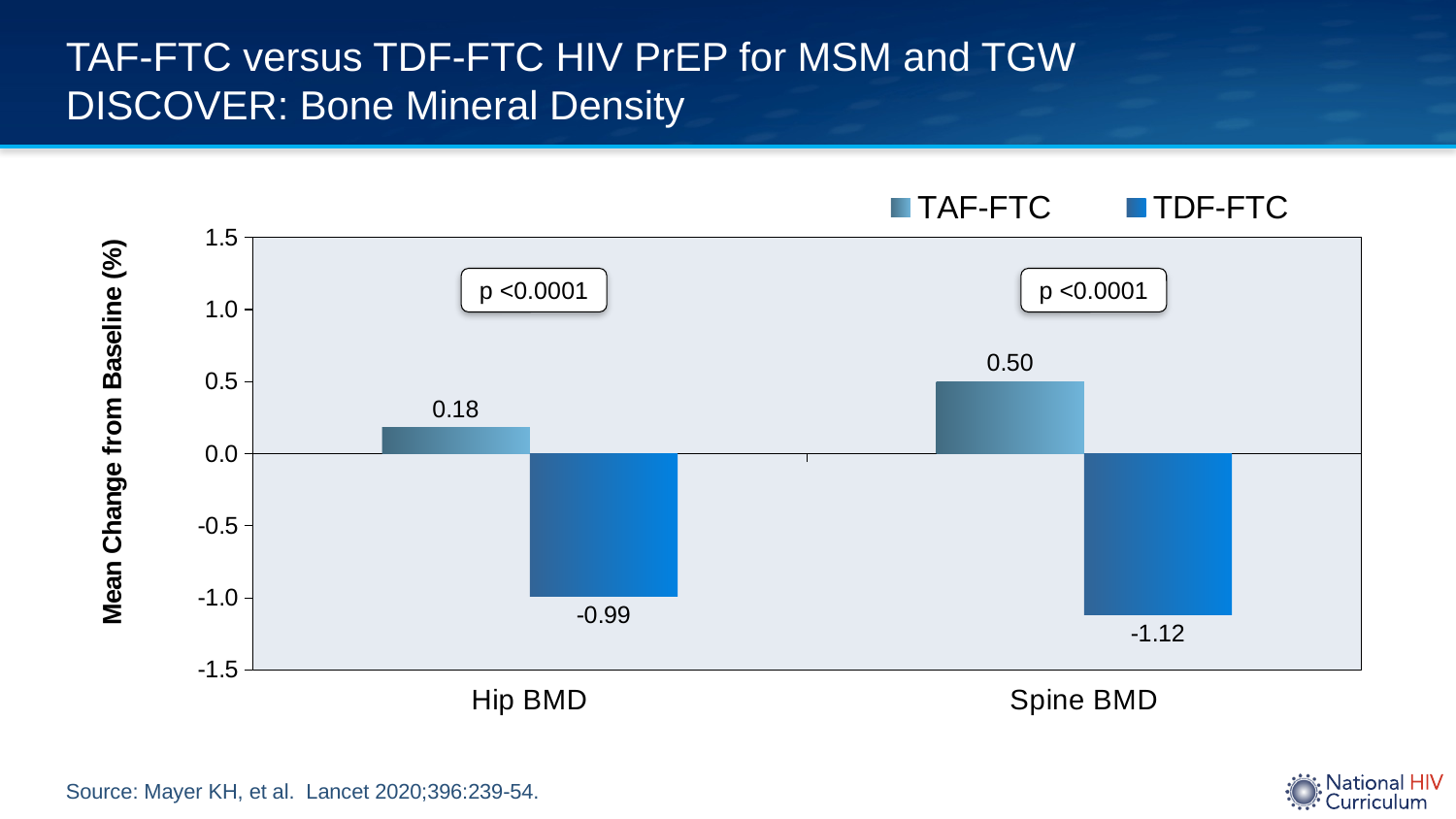
What is the mean change from baseline for TDF-FTC in Spine BMD? -1.12 What is the mean change from baseline for TAF-FTC in Spine BMD? 0.50 What is the mean change from baseline for TAF-FTC in Hip BMD? 0.18 Which is larger, the TAF-FTC value for Hip BMD or the TAF-FTC value for Spine BMD? Spine BMD What is the difference between the TAF-FTC and TDF-FTC values for Hip BMD? 1.17 What is the mean change from baseline for TDF-FTC in Hip BMD? -0.99 Which category has the highest TAF-FTC value? Spine BMD What is the label of the y axis? Mean Change from Baseline (%) Which category has the lowest TDF-FTC value? Spine BMD What kind of chart is shown on the slide? Bar chart How many categories are shown on the x axis? 2 How many series does the legend list? 2